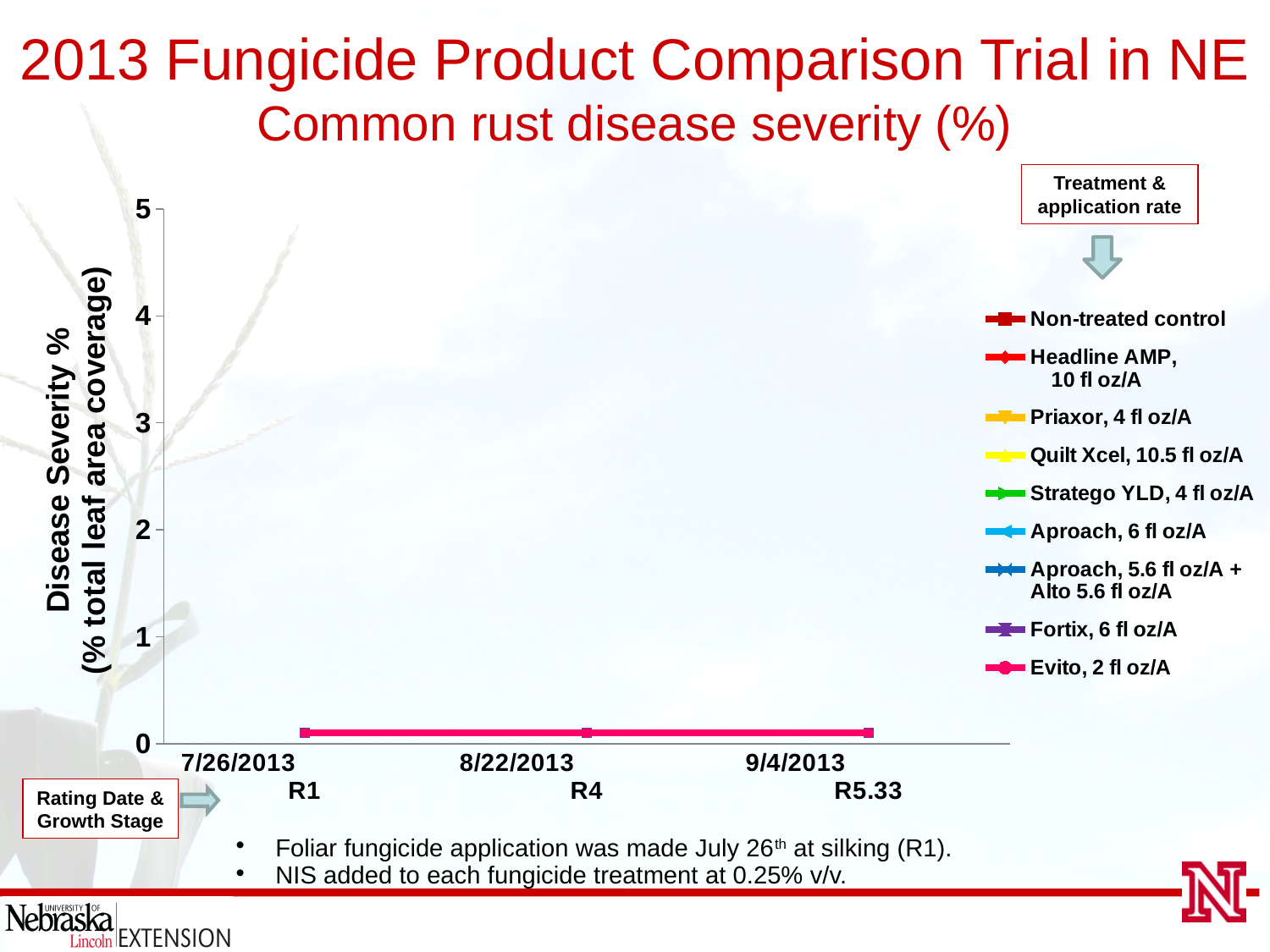
How many rating dates are shown on the x axis? 3 Do the plotted disease severity values rise, fall, or stay flat from 7/26/2013 to 9/4/2013? stay flat How many treatments does the legend list? 9 What kind of chart is shown on the slide? line chart What growth stage is listed under the rating date 9/4/2013? R5.33 What is the first rating date shown on the x axis? 7/26/2013 What is the maximum value shown on the y axis? 5 Which growth stage corresponds to the rating date 8/22/2013? R4 Is the disease severity value on 7/26/2013 greater or less than 1? less Is the disease severity value on 9/4/2013 greater or less than 1? less Is the disease severity value on 8/22/2013 greater or less than 2? less